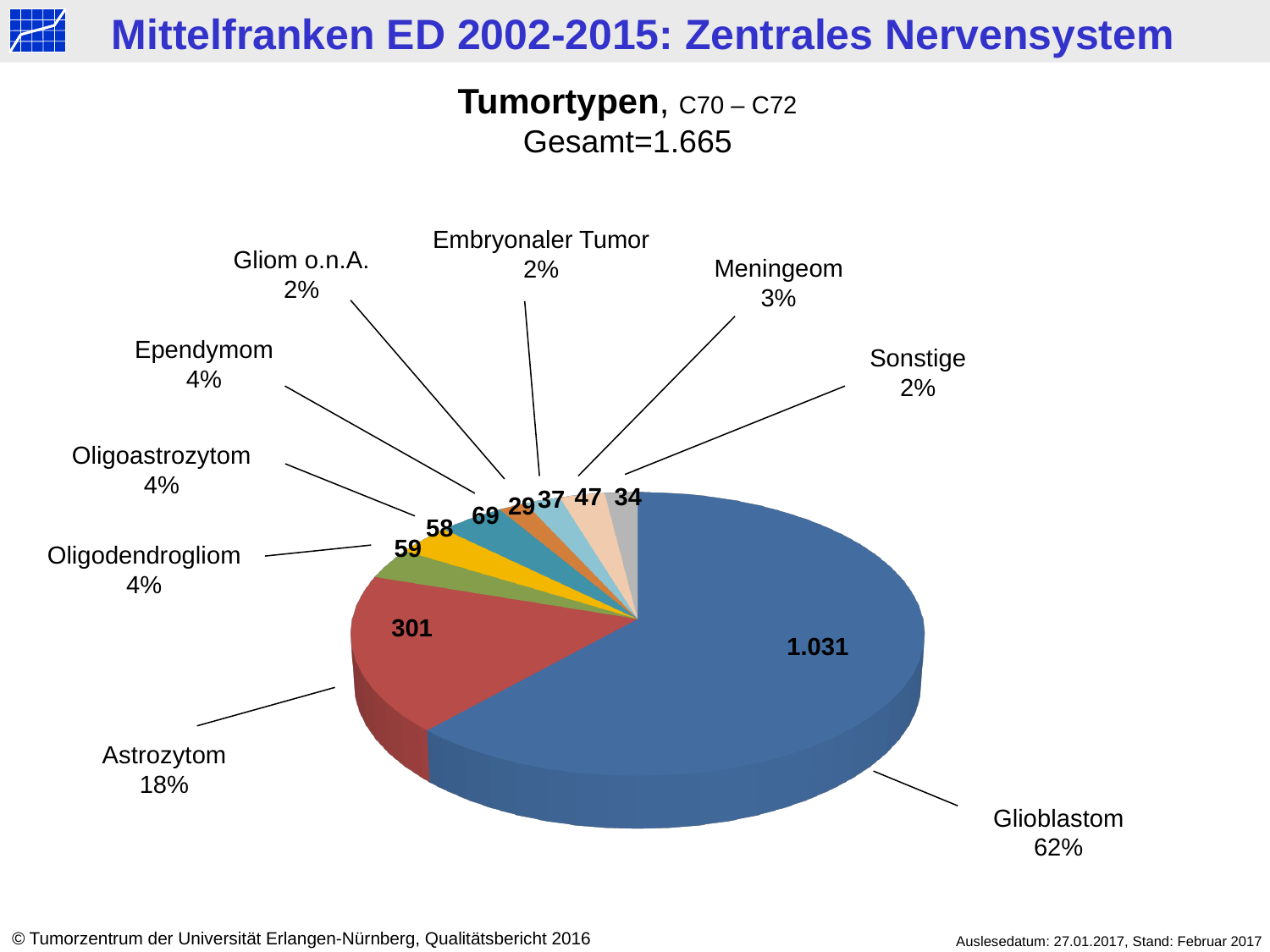
How many tumour types (slices) does the pie chart show? 9 Which tumour type has the smallest value? Gliom o.n.A. What is the difference between the values for Glioblastom and Astrozytom? 730 Which is larger, the value for Astrozytom or the value for Meningeom? Astrozytom What is the value shown for Astrozytom? 301 What share of the pie does Astrozytom account for? 18% Which tumour type has the largest slice? Glioblastom What is the value shown for Ependymom? 69 What total (Gesamt) is stated for the chart? 1.665 What kind of chart is shown on the slide? pie chart What is the value shown for Glioblastom? 1.031 What share of the pie does Glioblastom account for? 62%